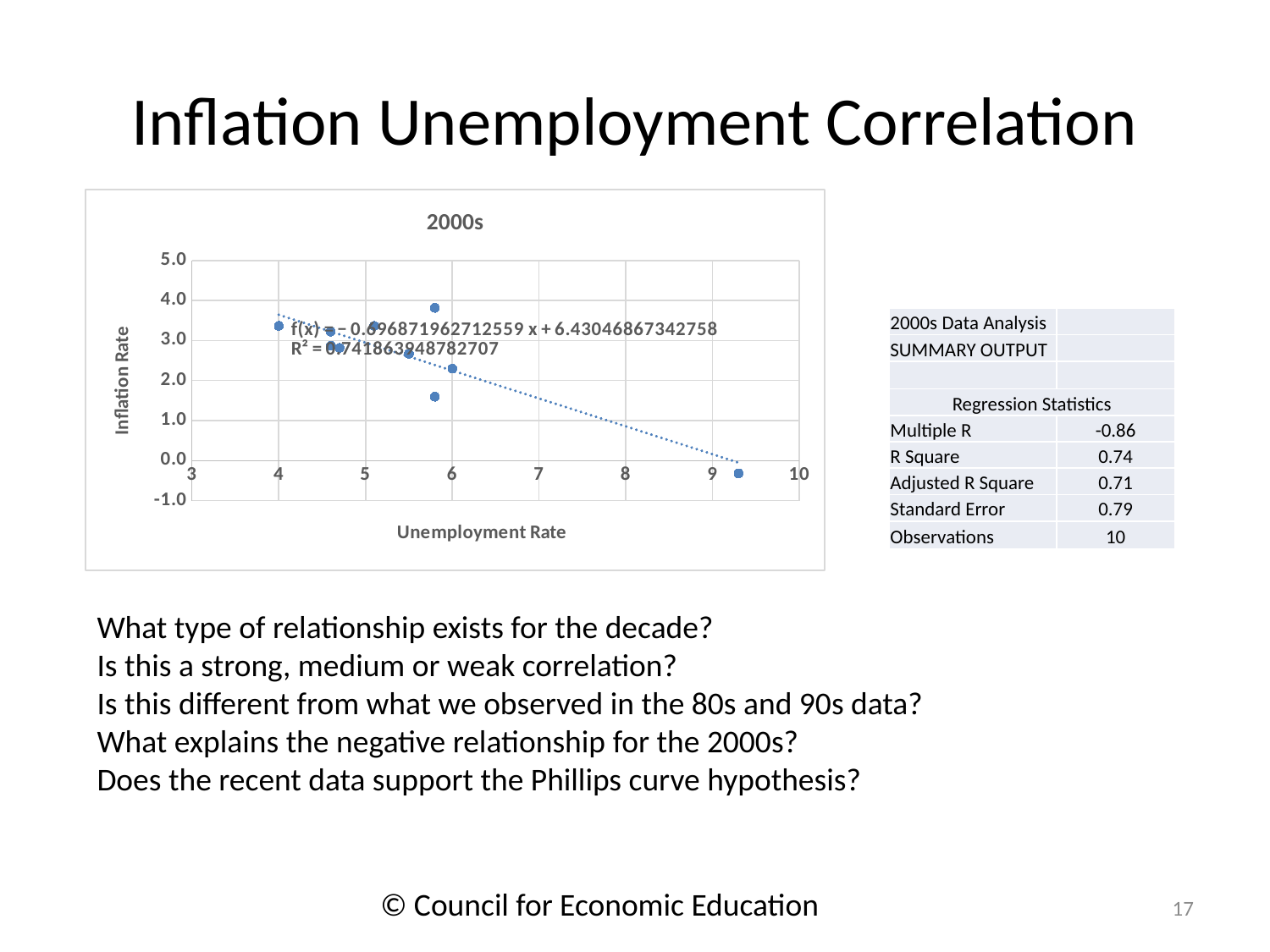
Is the inflation rate of the point at an unemployment rate of about 4 greater or less than 3.0? greater Which has the higher inflation rate: the point at an unemployment rate of about 4 or the point at an unemployment rate of about 9? The point at about 4 Is the inflation rate of the point with the highest unemployment rate (near 9) greater or less than 0.0? less As the unemployment rate increases along the x axis, do the inflation rate values generally rise or fall? Fall What is the highest value shown on the y axis of the chart? 5.0 Is the inflation rate of the highest point on the chart greater or less than 3.0? greater What is the label of the x axis of the chart? Unemployment Rate What kind of chart is shown on the slide? Scatter chart What is the title of the chart? 2000s